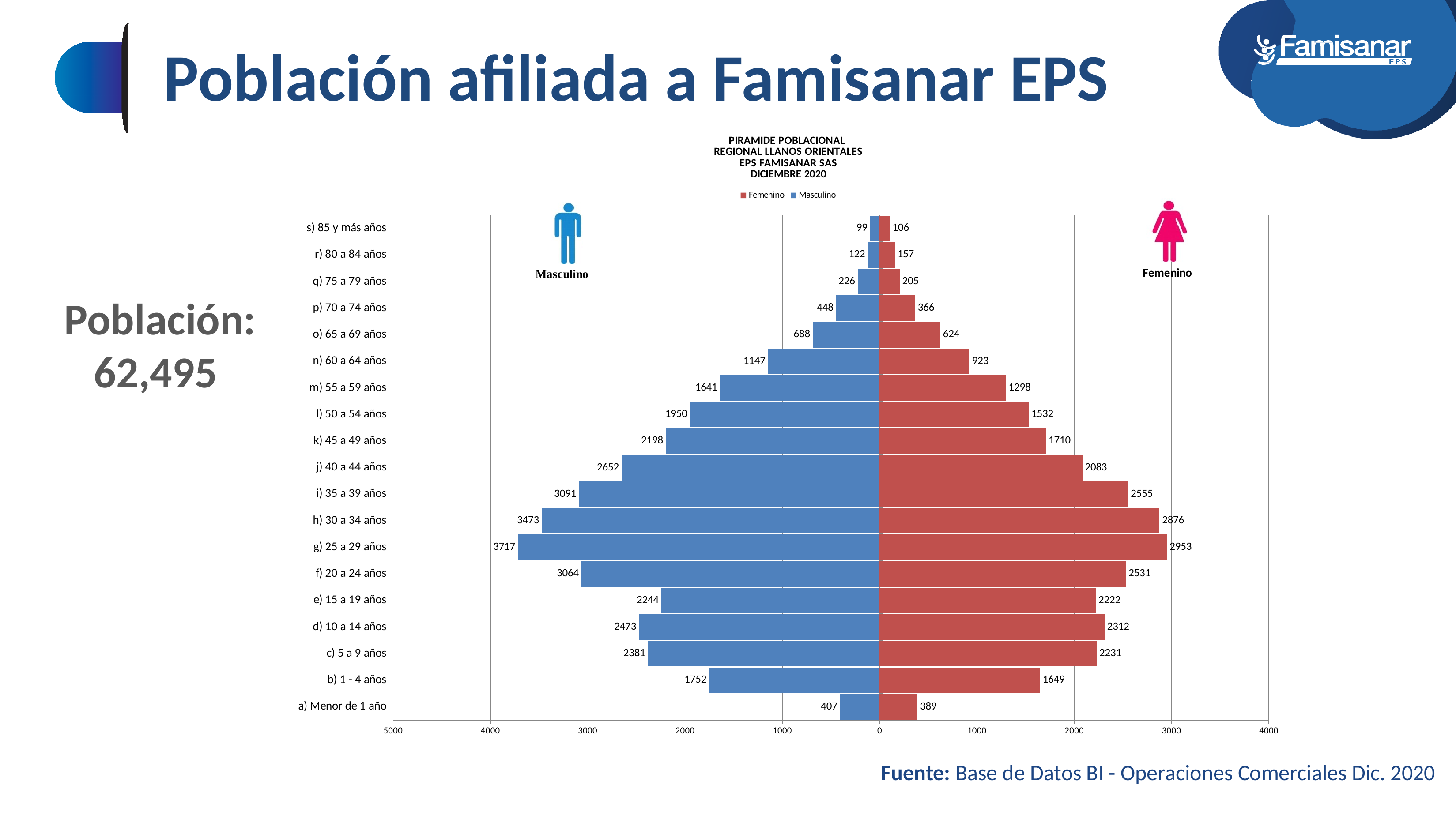
Which age group has the lowest Masculino value? s) 85 y más años What is the Masculino value for the age group g) 25 a 29 años? 3717 Which age group has the highest Femenino value? g) 25 a 29 años How many series does the legend list? 2 Which is larger for the age group q) 75 a 79 años, the Masculino value or the Femenino value? Masculino What is the difference between the Masculino and Femenino values for the age group j) 40 a 44 años? 569 What colour are the Femenino bars? Red Which age group has the highest Masculino value? g) 25 a 29 años What is the Femenino value for the age group a) Menor de 1 año? 389 How many age groups are shown in the population pyramid? 19 What is the Femenino value for the age group h) 30 a 34 años? 2876 What kind of chart is shown on the slide? Bar chart